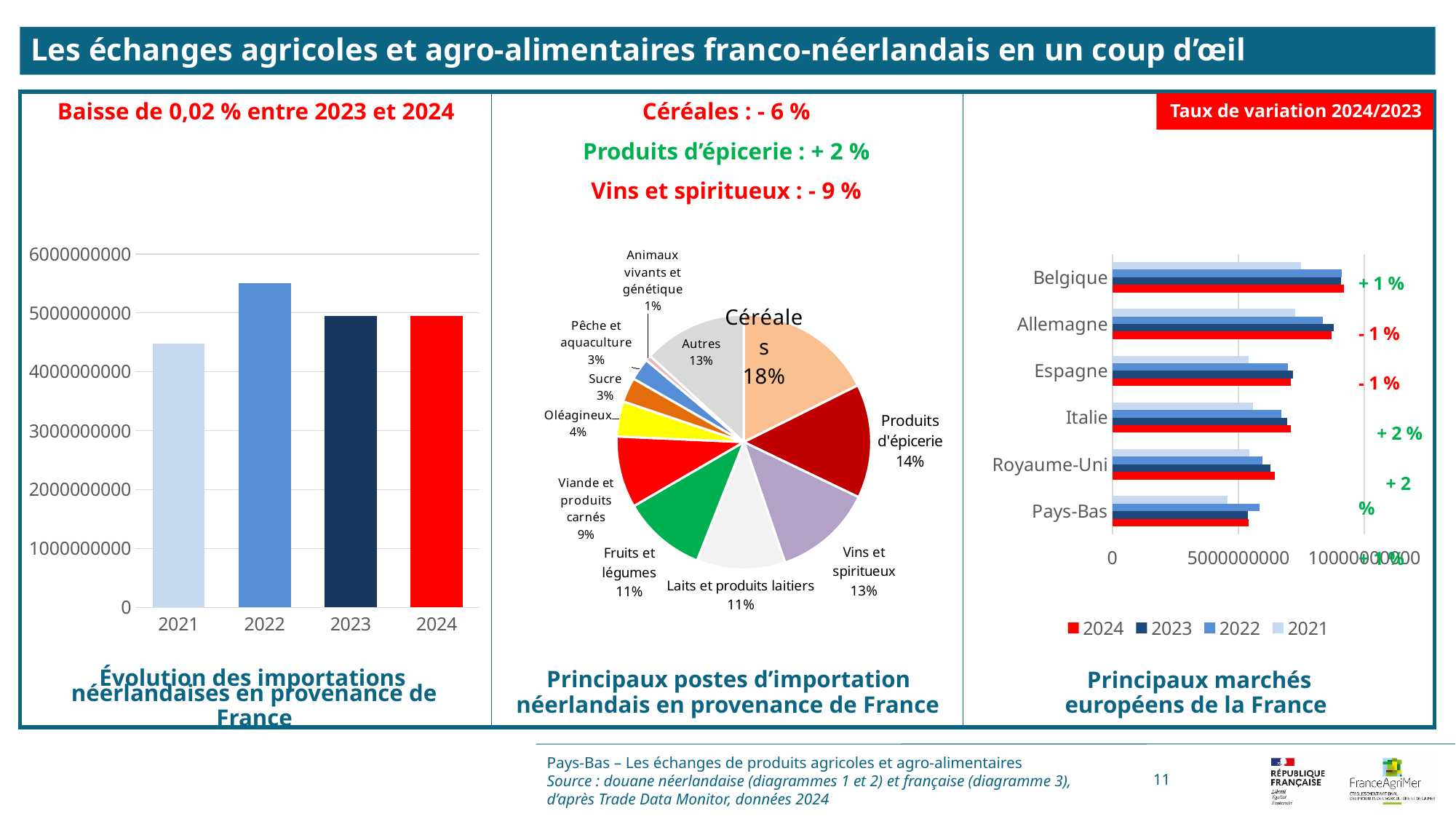
In the left chart 'Évolution des importations néerlandaises en provenance de France', is the value for 2022 greater or less than 5000000000? greater What kind of chart is the left chart, 'Évolution des importations néerlandaises en provenance de France'? bar chart In the pie chart 'Principaux postes d'importation néerlandais en provenance de France', which slice is the smallest? Animaux vivants et génétique In the right chart 'Principaux marchés européens de la France', is the 2024 value for Pays-Bas greater or less than 10000000000? less How many years are shown in the left chart 'Évolution des importations néerlandaises en provenance de France'? 4 In the pie chart 'Principaux postes d'importation néerlandais en provenance de France', what is the difference in percentage points between Céréales and Produits d'épicerie? 4 percentage points In the left chart 'Évolution des importations néerlandaises en provenance de France', which year has the highest value? 2022 In the pie chart 'Principaux postes d'importation néerlandais en provenance de France', what share does Céréales have? 18% In the left chart 'Évolution des importations néerlandaises en provenance de France', which year has the lowest value? 2021 How many slices does the pie chart 'Principaux postes d'importation néerlandais en provenance de France' have? 11 How many series does the legend of the right chart 'Principaux marchés européens de la France' list? 4 In the right chart 'Principaux marchés européens de la France', which country has the highest 2024 value? Belgique